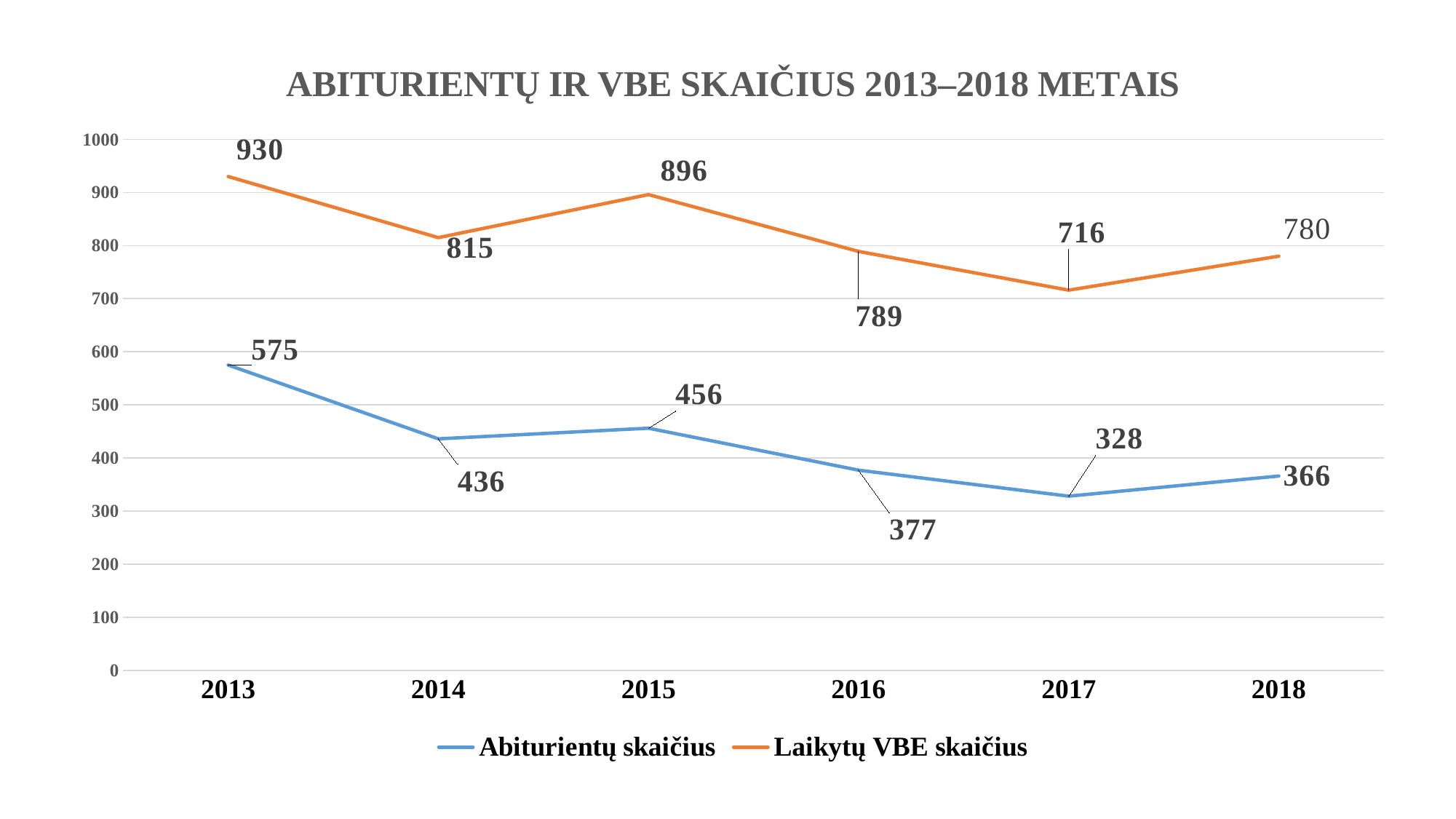
In which year is Laikytų VBE skaičius highest? 2013 What is the title of the chart? ABITURIENTŲ IR VBE SKAIČIUS 2013–2018 METAIS How many series does the legend list? 2 Which is larger: Abiturientų skaičius in 2014 or in 2018? 2014 What kind of chart is shown on the slide? line chart What is the value of Laikytų VBE skaičius in 2016? 789 What is the difference between Laikytų VBE skaičius and Abiturientų skaičius in 2015? 440 What is the value of Laikytų VBE skaičius in 2018? 780 In which year is Abiturientų skaičius lowest? 2017 What is the value of Abiturientų skaičius in 2013? 575 How many years are shown on the x axis? 6 Does Abiturientų skaičius rise or fall from 2013 to 2014? fall